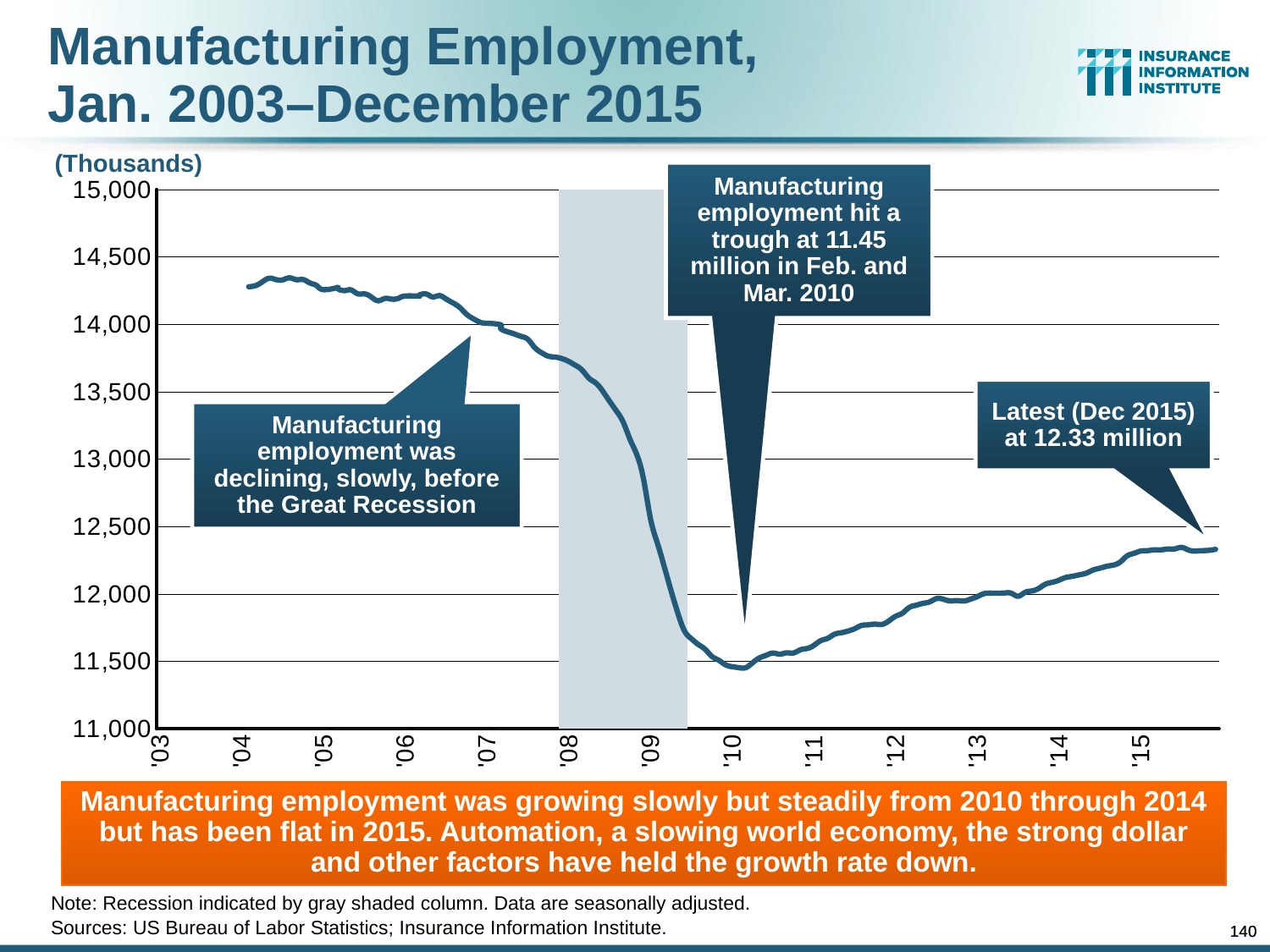
Is the value for manufacturing employment in 2011 greater or less than 12,000? less Does manufacturing employment rise or fall from 2010 through 2014? rise What is the latest (Dec 2015) value of manufacturing employment shown on the chart? 12.33 million What does the gray shaded column on the chart indicate? Recession Is the value for manufacturing employment in 2004 greater or less than 14,000? greater Which is larger, manufacturing employment in 2004 or in 2015? 2004 In which months did manufacturing employment hit its trough, according to the callout? Feb. and Mar. 2010 Is the value for manufacturing employment in 2015 greater or less than 12,000? greater Does manufacturing employment rise or fall from 2003 to 2009? fall What kind of chart is shown on the slide? line chart By how much is the Dec 2015 value (12.33 million) higher than the trough value (11.45 million)? 0.88 million According to the callout, what value did manufacturing employment hit at its trough? 11.45 million